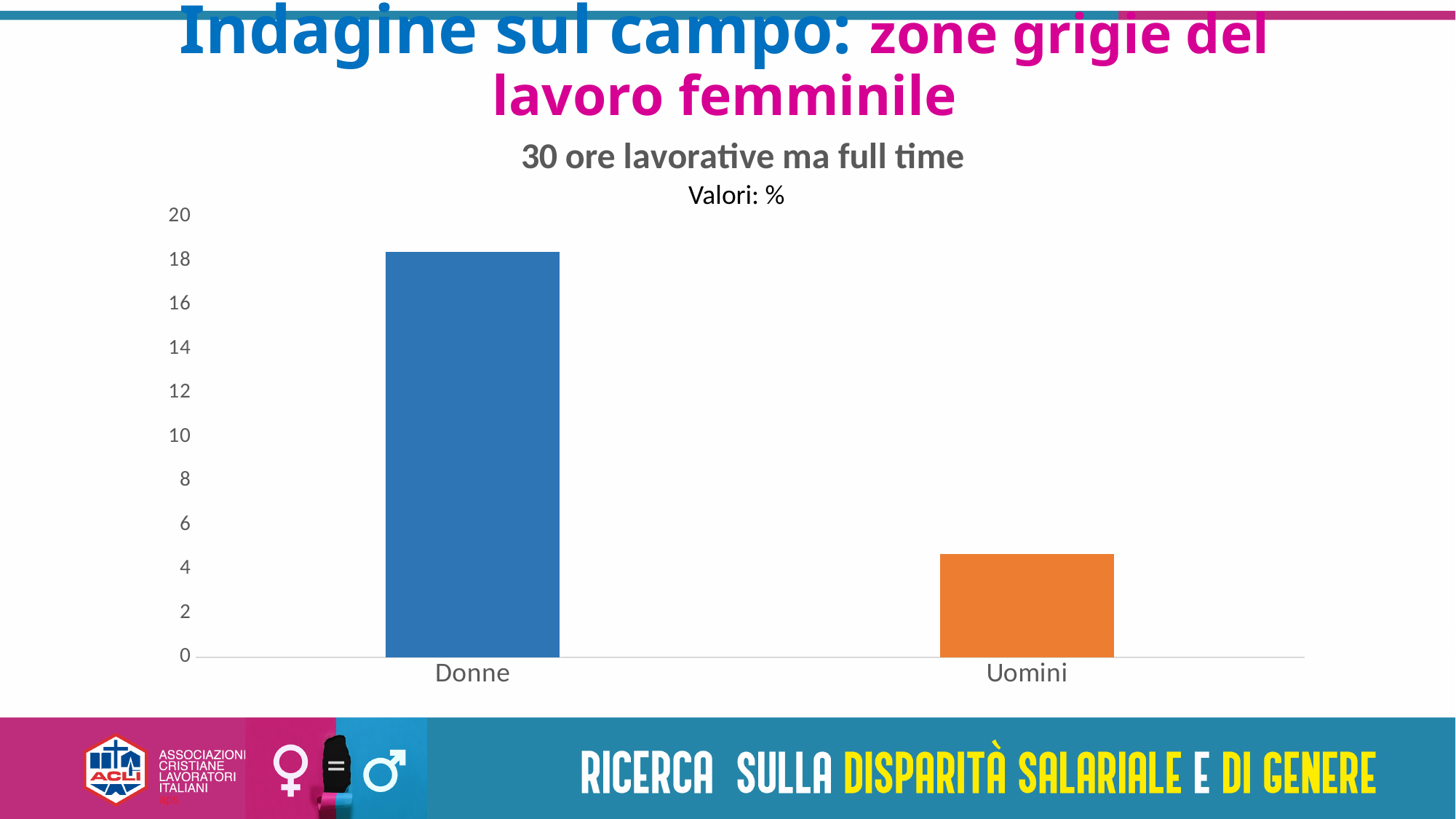
Which category has the highest value in the chart? Donne What is the title of the chart? 30 ore lavorative ma full time How many categories are plotted in the chart? 2 Is the value for Uomini greater or less than 6? less What unit does the chart's subtitle say the values are in? % What kind of chart is shown on the slide? bar chart Which is larger, the value for Donne or the value for Uomini? Donne Is the value for Uomini greater or less than 2? greater Which category has the lowest value in the chart? Uomini Is the value for Donne greater or less than 16? greater